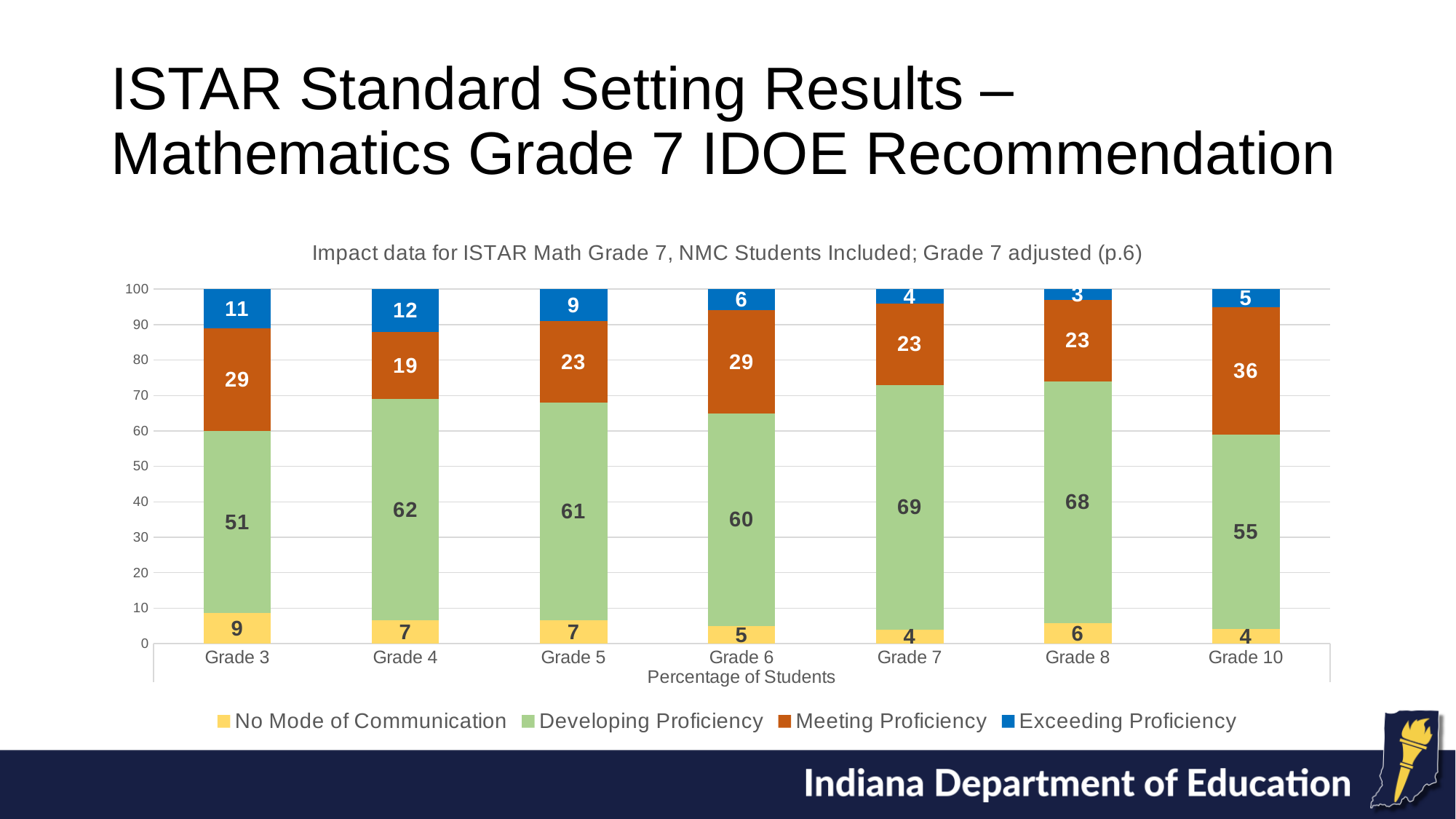
What is the Meeting Proficiency value for Grade 10? 36 Which grade has the highest Exceeding Proficiency value? Grade 4 How many grade categories are shown on the x axis? 7 What is the Developing Proficiency value for Grade 7? 69 Which grade has the highest Meeting Proficiency value? Grade 10 What is the difference between the Meeting Proficiency values for Grade 10 and Grade 4? 17 What kind of chart is shown on the slide? Stacked bar chart Which has the larger Developing Proficiency value, Grade 4 or Grade 5? Grade 4 Which grade has the lowest Exceeding Proficiency value? Grade 8 What is the total of the stacked bar for Grade 3? 100 What is the No Mode of Communication value for Grade 3? 9 How many series does the legend list? 4